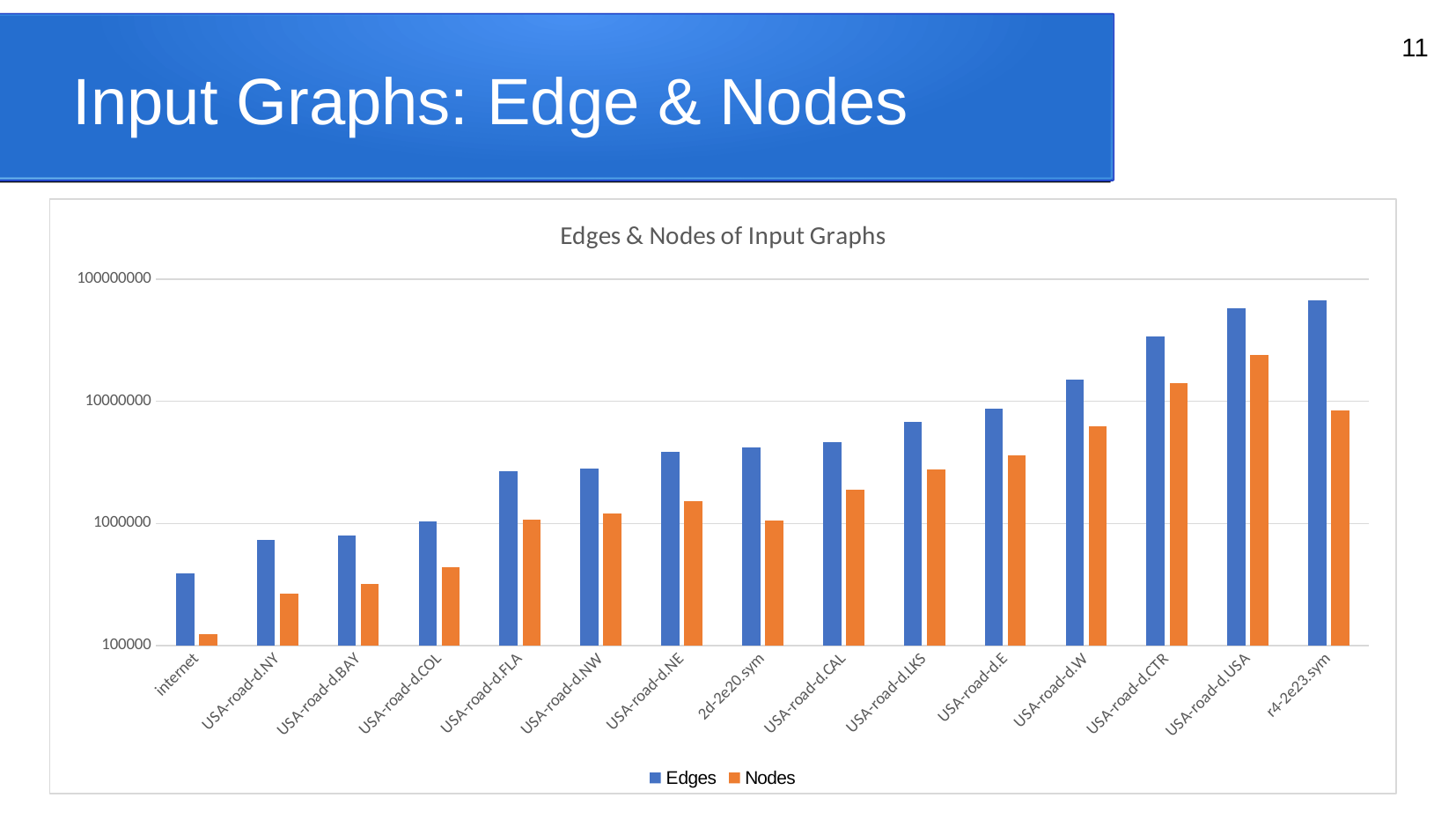
Is the Edges value for internet greater or less than 1000000? less What is the title of the chart? Edges & Nodes of Input Graphs What kind of chart is shown on the slide? bar chart Is the Edges value for r4-2e23.sym greater or less than 10000000? greater How many input graphs (categories) are shown on the x axis? 15 Which input graph has the lowest number of Nodes? internet For r4-2e23.sym, which is larger: Edges or Nodes? Edges Is the Nodes value for USA-road-d.CTR greater or less than 10000000? greater Which input graph has the highest number of Nodes? USA-road-d.USA How many series does the legend list? 2 Which input graph has the lowest number of Edges? internet Do the Edges values generally rise or fall from left to right along the x axis? rise